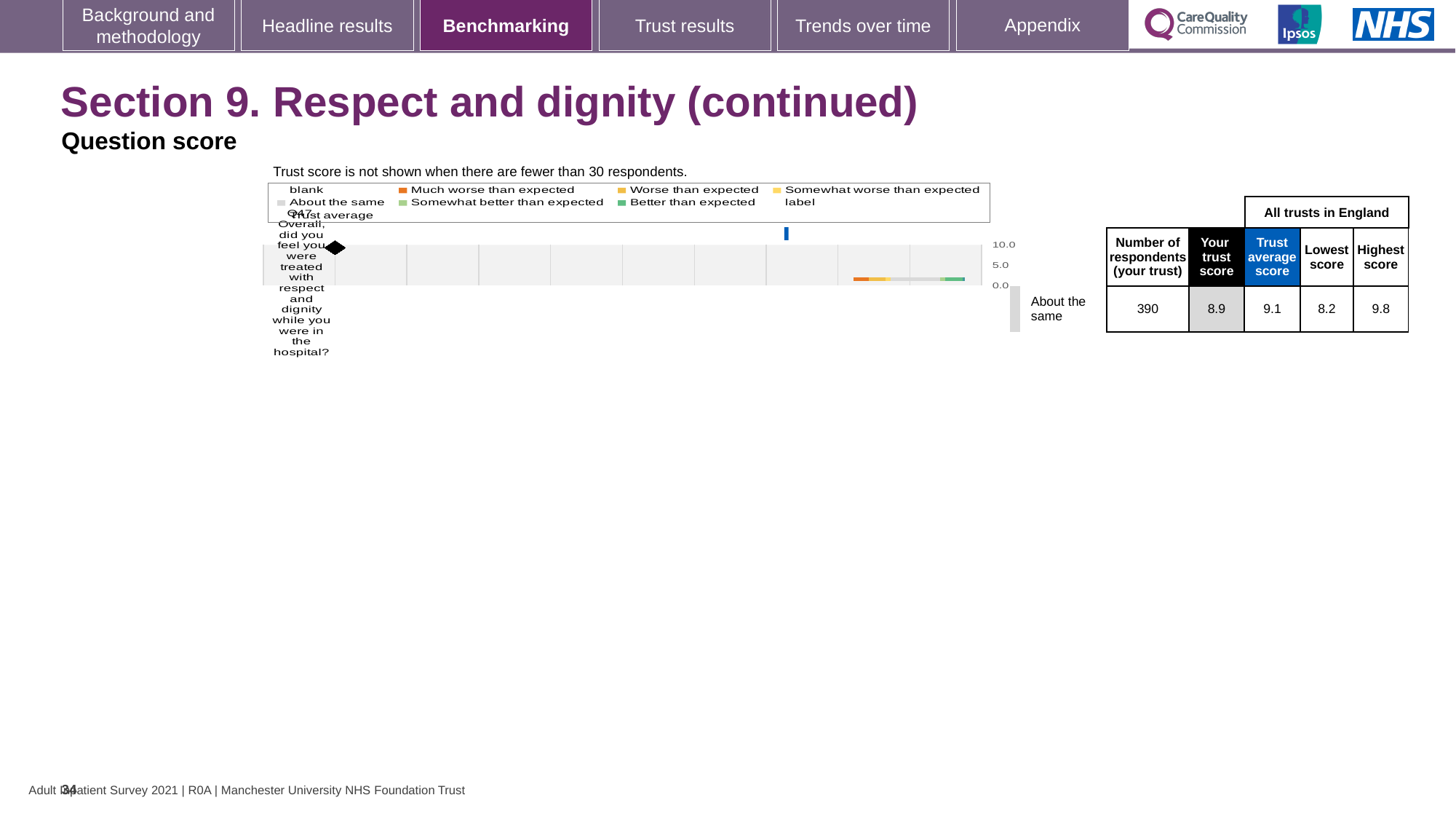
Which is larger for Q47: the trust's own score or the trust average score? Trust average score How many survey questions are plotted on the chart? 1 What benchmarking category is the trust's Q47 result labelled as on the chart? About the same How many respondents from the trust answered Q47, according to the table next to the chart? 390 According to the table next to the chart, what is the trust average score for Q47? 9.1 What is the difference between the highest score and the lowest score for Q47 in the table next to the chart? 1.6 What is the highest value shown on the chart's score axis? 10.0 What colour represents 'Much worse than expected' in the chart legend? orange What kind of chart is shown on the slide? bar chart According to the table next to the chart, what is the highest score among all trusts in England for Q47? 9.8 According to the table next to the chart, what is the trust's score for Q47? 8.9 According to the table next to the chart, what is the lowest score among all trusts in England for Q47? 8.2